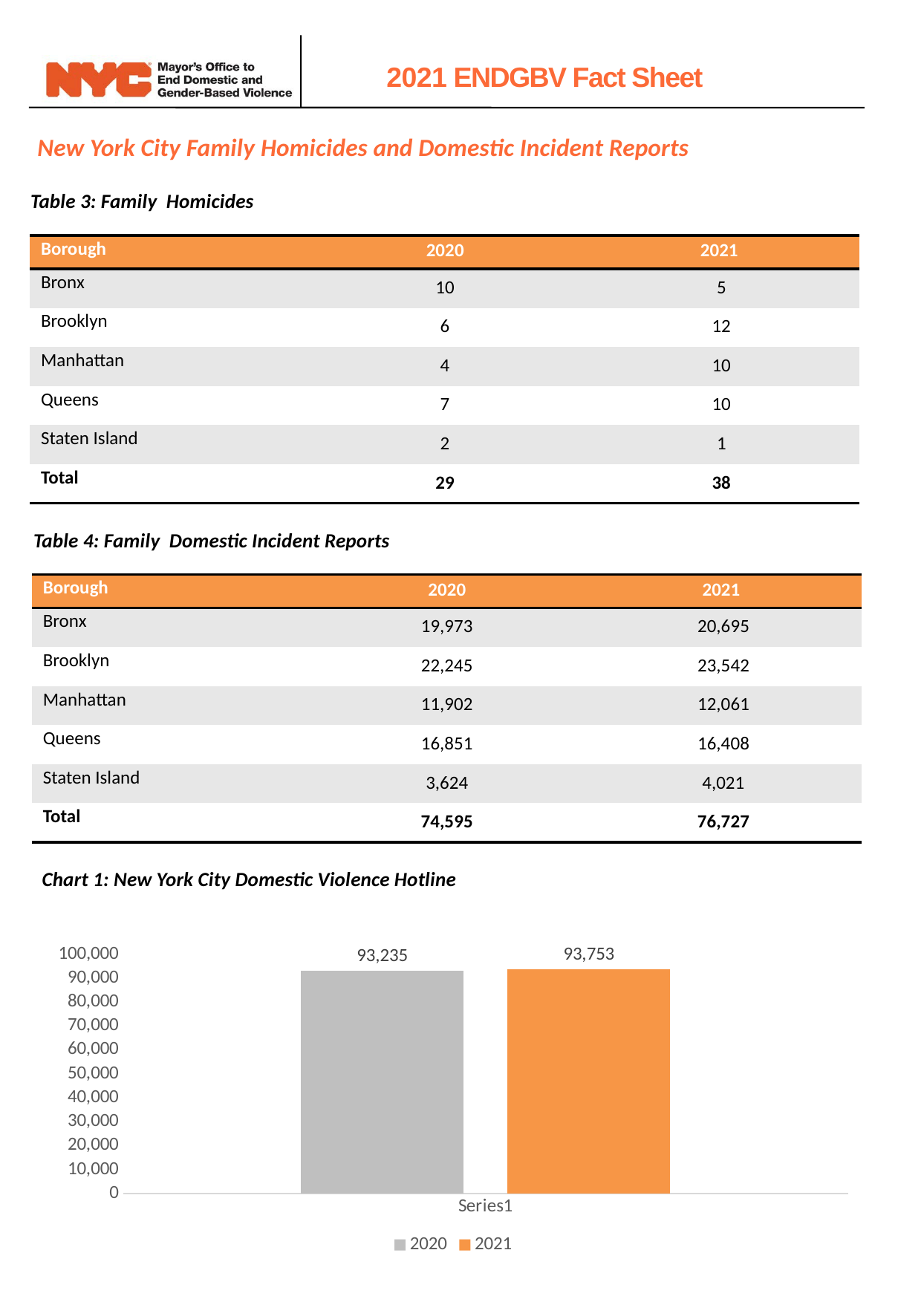
In Chart 1: New York City Domestic Violence Hotline, what is the value for 2020? 93,235 How many series does the legend of Chart 1: New York City Domestic Violence Hotline list? 2 In Chart 1: New York City Domestic Violence Hotline, is the value for 2020 greater or less than 90,000? greater In Chart 1: New York City Domestic Violence Hotline, what colour is the bar for 2021? orange In Chart 1: New York City Domestic Violence Hotline, which series has the lowest value? 2020 In Chart 1: New York City Domestic Violence Hotline, what is the difference between the 2021 and 2020 values? 518 What kind of chart is Chart 1: New York City Domestic Violence Hotline? bar chart In Chart 1: New York City Domestic Violence Hotline, what is the value for 2021? 93,753 In Chart 1: New York City Domestic Violence Hotline, does the value rise or fall from 2020 to 2021? rise In Chart 1: New York City Domestic Violence Hotline, which series has the highest value? 2021 In Chart 1: New York City Domestic Violence Hotline, is the value for 2021 greater or less than 100,000? less In Chart 1: New York City Domestic Violence Hotline, which year has the higher value, 2020 or 2021? 2021